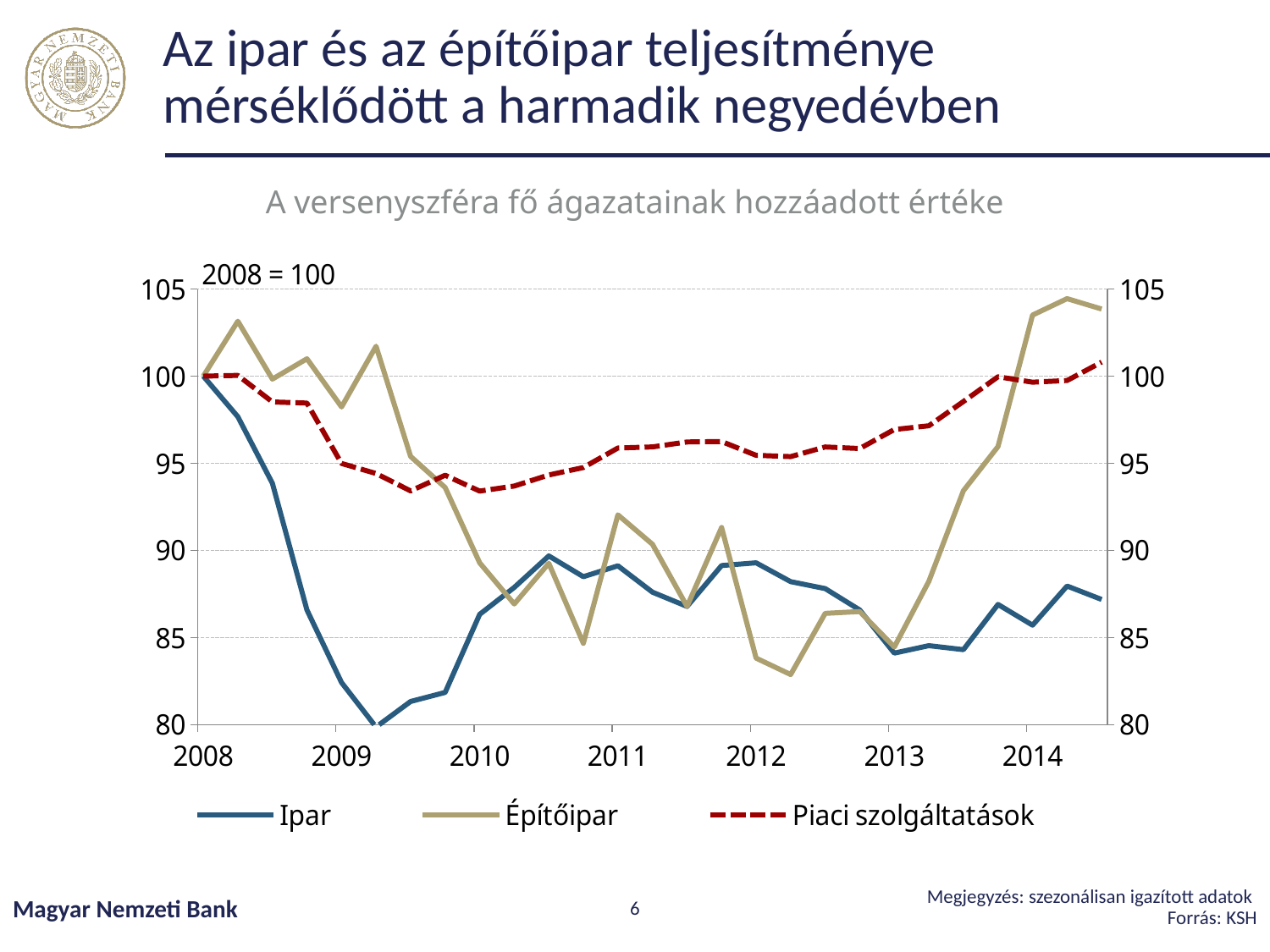
What kind of chart is shown on the slide? line chart At the start of 2012, which is larger, Piaci szolgáltatások or Ipar? Piaci szolgáltatások Is the value for Építőipar in mid-2014 greater or less than 100? greater Which series has the lowest value in mid-2009? Ipar Is the value for Ipar at the start of 2010 greater or less than 85? greater Which series is drawn with a dashed line? Piaci szolgáltatások How many series does the legend list? 3 At the start of 2014, which is larger, Építőipar or Ipar? Építőipar What is the title of the chart? A versenyszféra fő ágazatainak hozzáadott értéke Is the value for Piaci szolgáltatások at the start of 2010 greater or less than 95? less Does the Ipar series rise or fall from 2008 to 2009? fall What is the value of Ipar at the start of 2008? 100